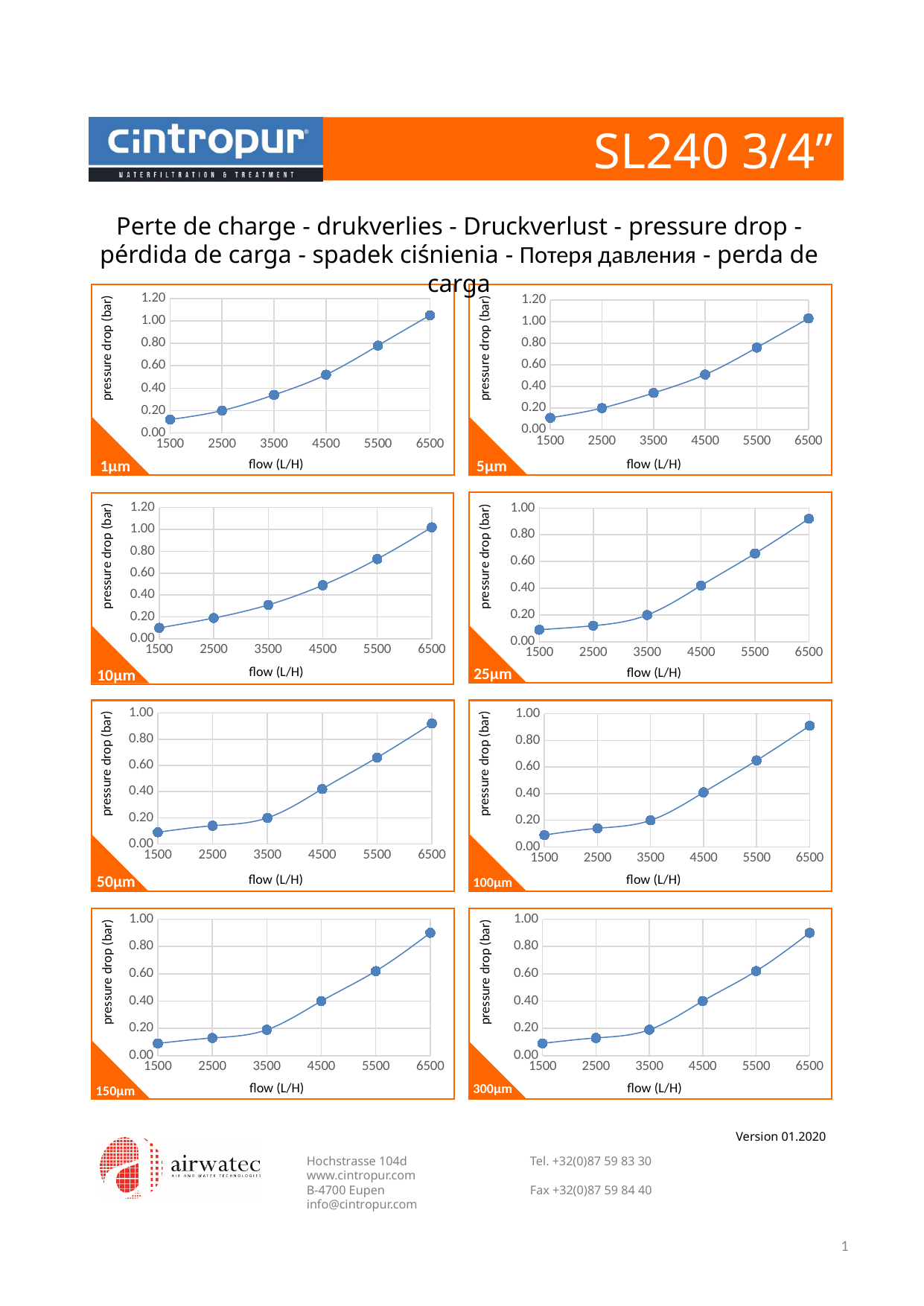
On the 300µm chart, at which flow value is the pressure drop lowest? 1500 On the 300µm chart, is the pressure drop at 1500 L/H greater or less than 0.20? less On the 50µm chart, which is larger: the pressure drop at 5500 L/H or at 3500 L/H? 5500 L/H What is the x-axis label on the 100µm chart? flow (L/H) On the 10µm chart, does the pressure drop rise or fall as flow increases? rise On the 25µm chart, at which flow value is the pressure drop highest? 6500 How many data points are plotted on the 5µm chart? 6 On the 1µm chart, is the pressure drop at 6500 L/H greater or less than 1.00? greater On the 25µm chart, is the pressure drop at 6500 L/H greater or less than 0.80? greater What kind of chart is the 1µm chart? line chart What is the y-axis label on the 150µm chart? pressure drop (bar)